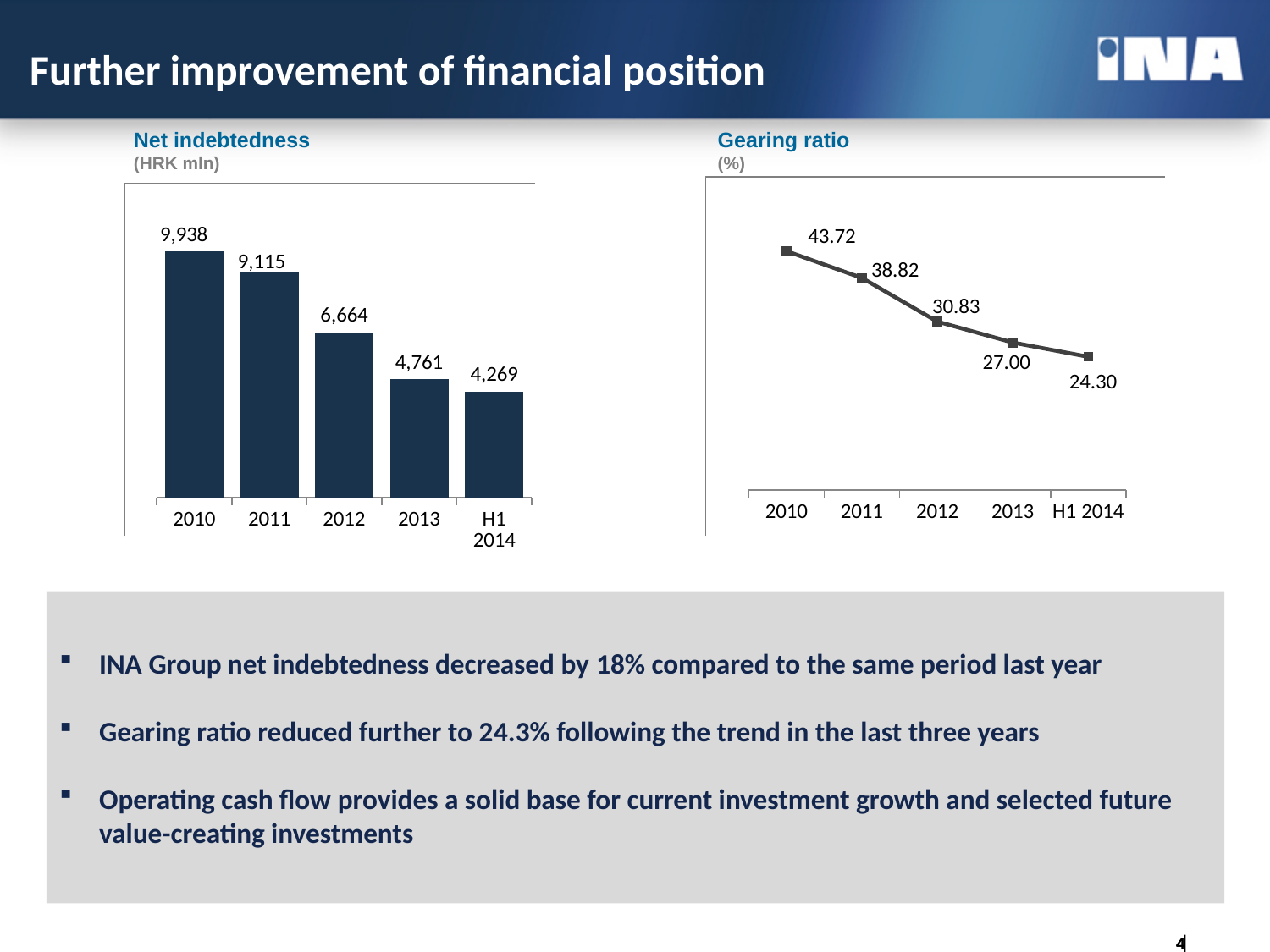
In the Net indebtedness chart, what is the difference between the 2012 and 2013 values? 1,903 In the Gearing ratio chart, do the values rise or fall from 2010 to H1 2014? Fall In the Net indebtedness chart, what is the value for 2010? 9,938 In the Gearing ratio chart, what is the difference between the 2010 and 2011 values? 4.90 What kind of chart is the Net indebtedness chart? Bar chart In the Net indebtedness chart, which year has the lowest value? H1 2014 In the Gearing ratio chart, what is the value for 2012? 30.83 What kind of chart is the Gearing ratio chart? Line chart In the Gearing ratio chart, which year has the highest value? 2010 In the Net indebtedness chart, what is the value for H1 2014? 4,269 In the Gearing ratio chart, what is the value for 2013? 27.00 In the Net indebtedness chart, how many bars are plotted? 5